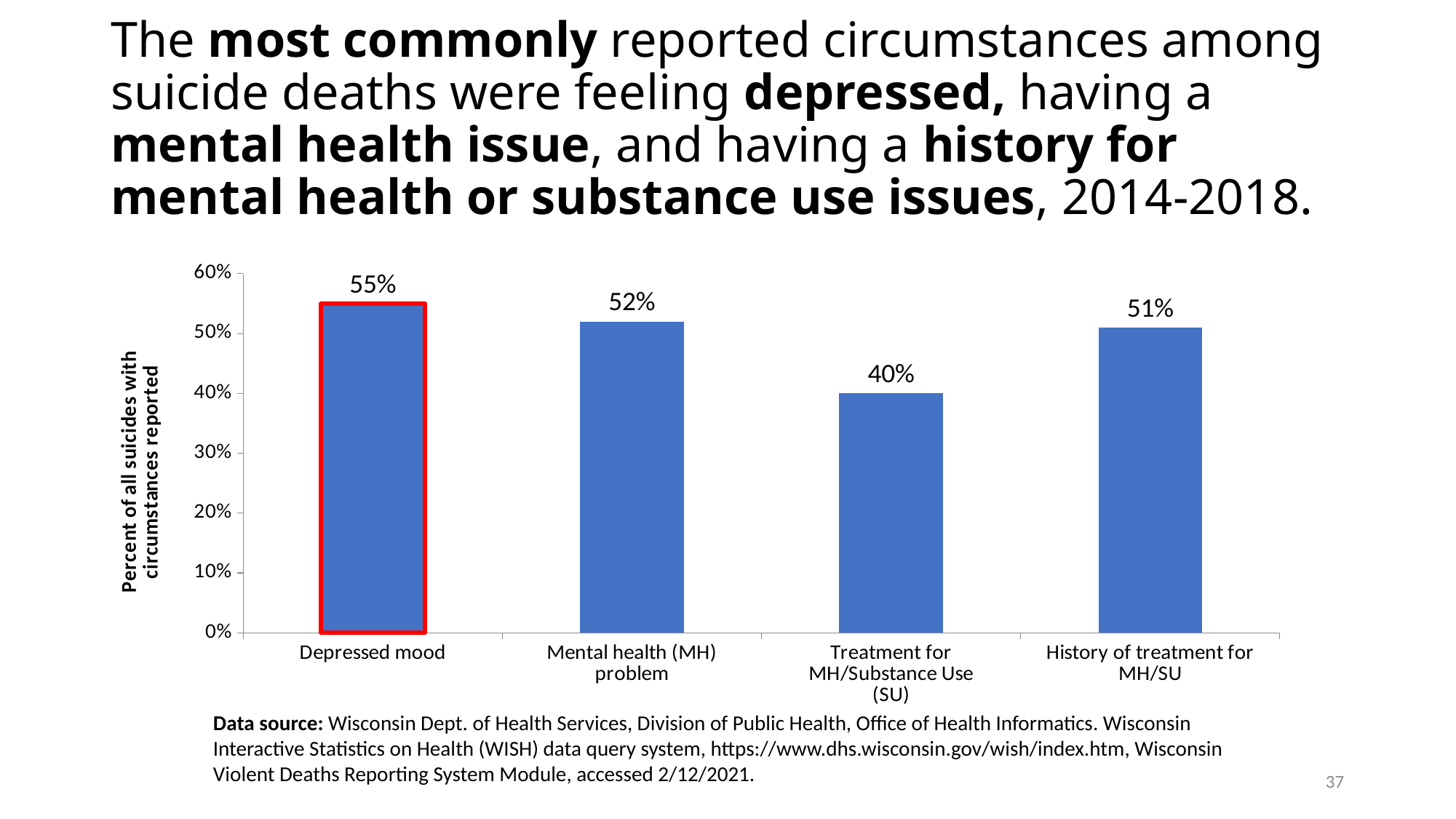
What is the value for History of treatment for MH/SU? 51% What is the difference between the values for Mental health (MH) problem and History of treatment for MH/SU? 1% Which is larger, the value for Depressed mood or the value for Treatment for MH/Substance Use (SU)? Depressed mood Which bar is outlined in red? Depressed mood What is the value for Mental health (MH) problem? 52% What is the difference between the values for Depressed mood and Treatment for MH/Substance Use (SU)? 15% Which category has the lowest value? Treatment for MH/Substance Use (SU) What percent of all suicides with circumstances reported had a depressed mood? 55% Which category has the highest value? Depressed mood How many categories are shown in the chart? 4 What is the value for Treatment for MH/Substance Use (SU)? 40% What kind of chart is shown on the slide? Bar chart